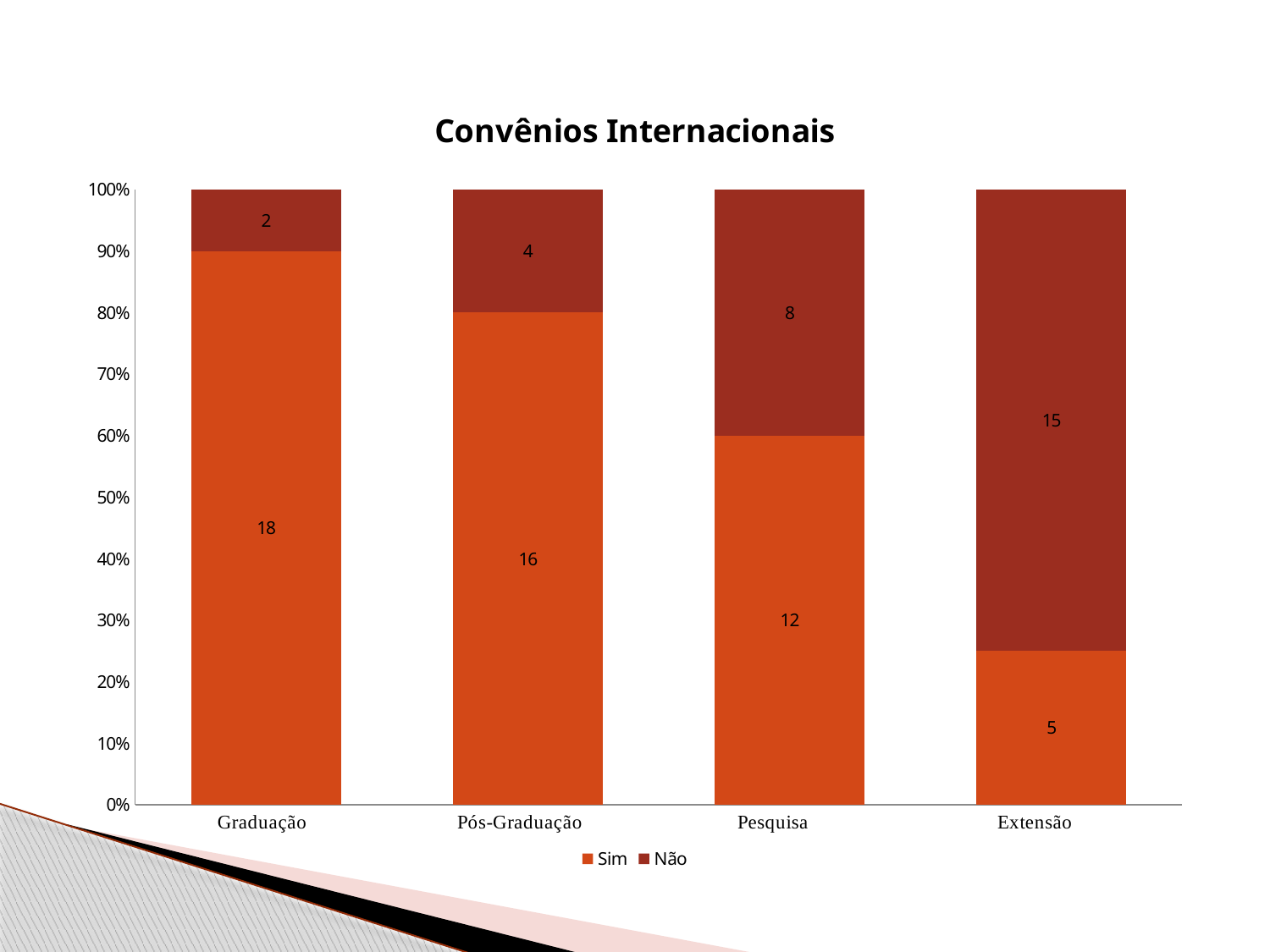
What is the value of the Sim series for Graduação? 18 Which category has the lowest Sim value? Extensão What kind of chart is shown on the slide? Stacked bar chart Which category has the highest Não value? Extensão How many categories are shown on the x axis? 4 What is the total of the Sim and Não values for Extensão? 20 What is the value of the Sim series for Pesquisa? 12 What is the title of the chart? Convênios Internacionais What is the difference between the Sim and Não values for Pós-Graduação? 12 What is the value of the Não series for Extensão? 15 Which is larger for Pesquisa, the Sim value or the Não value? Sim How many series does the legend list? 2